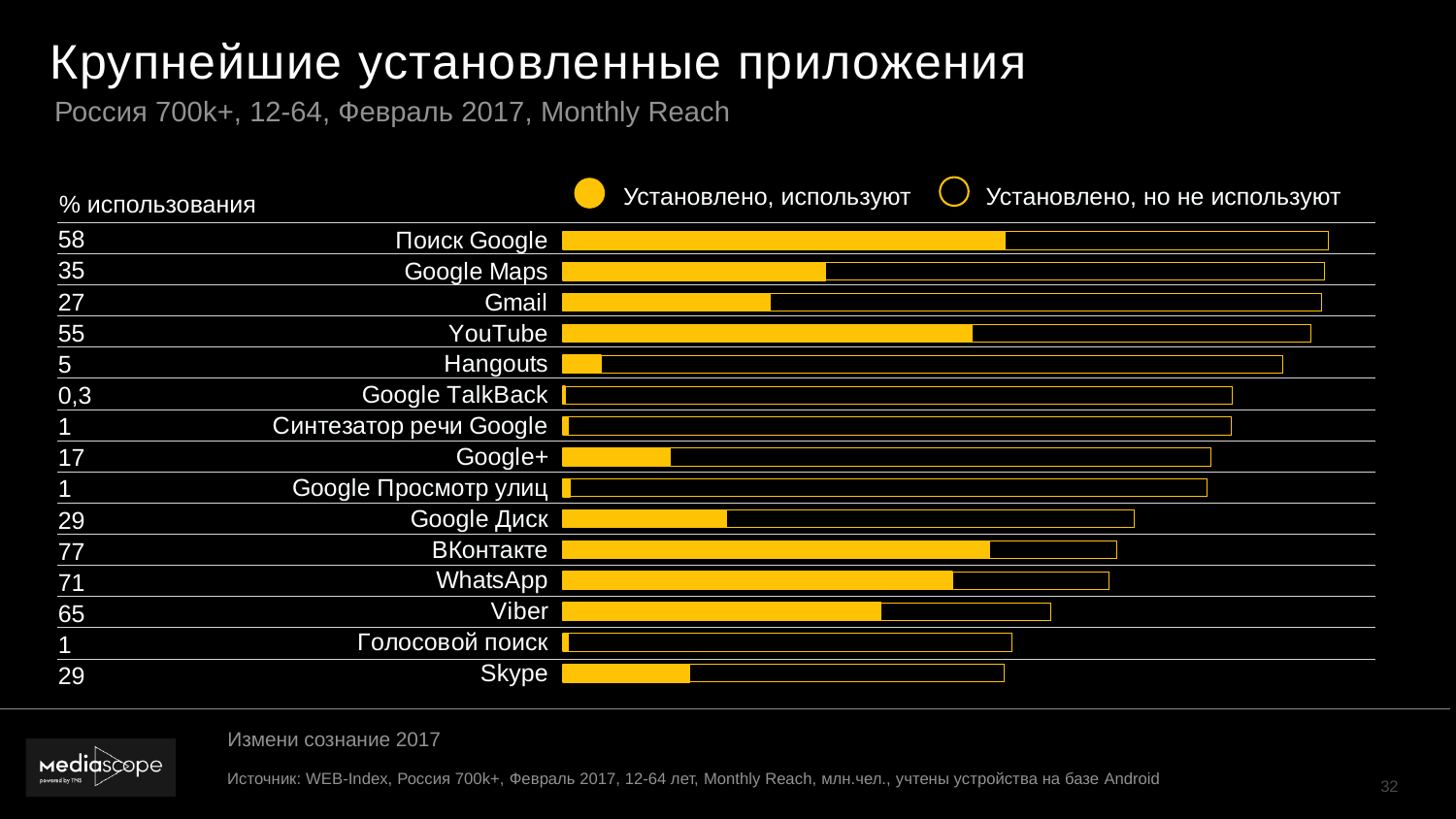
How many series does the legend list? 2 What kind of chart is shown on the slide? Bar chart What is the % использования value for Поиск Google? 58 What does the filled yellow circle in the legend represent? Установлено, используют What is the difference in % использования between Viber and Skype? 36 Which has a higher % использования, Google Maps or Gmail? Google Maps Which app has the highest % использования? ВКонтакте How many apps are listed in the chart? 15 What is the difference in % использования between ВКонтакте and WhatsApp? 6 What is the % использования value for YouTube? 55 Which app has the lowest % использования? Google TalkBack What is the % использования value for Google TalkBack? 0,3